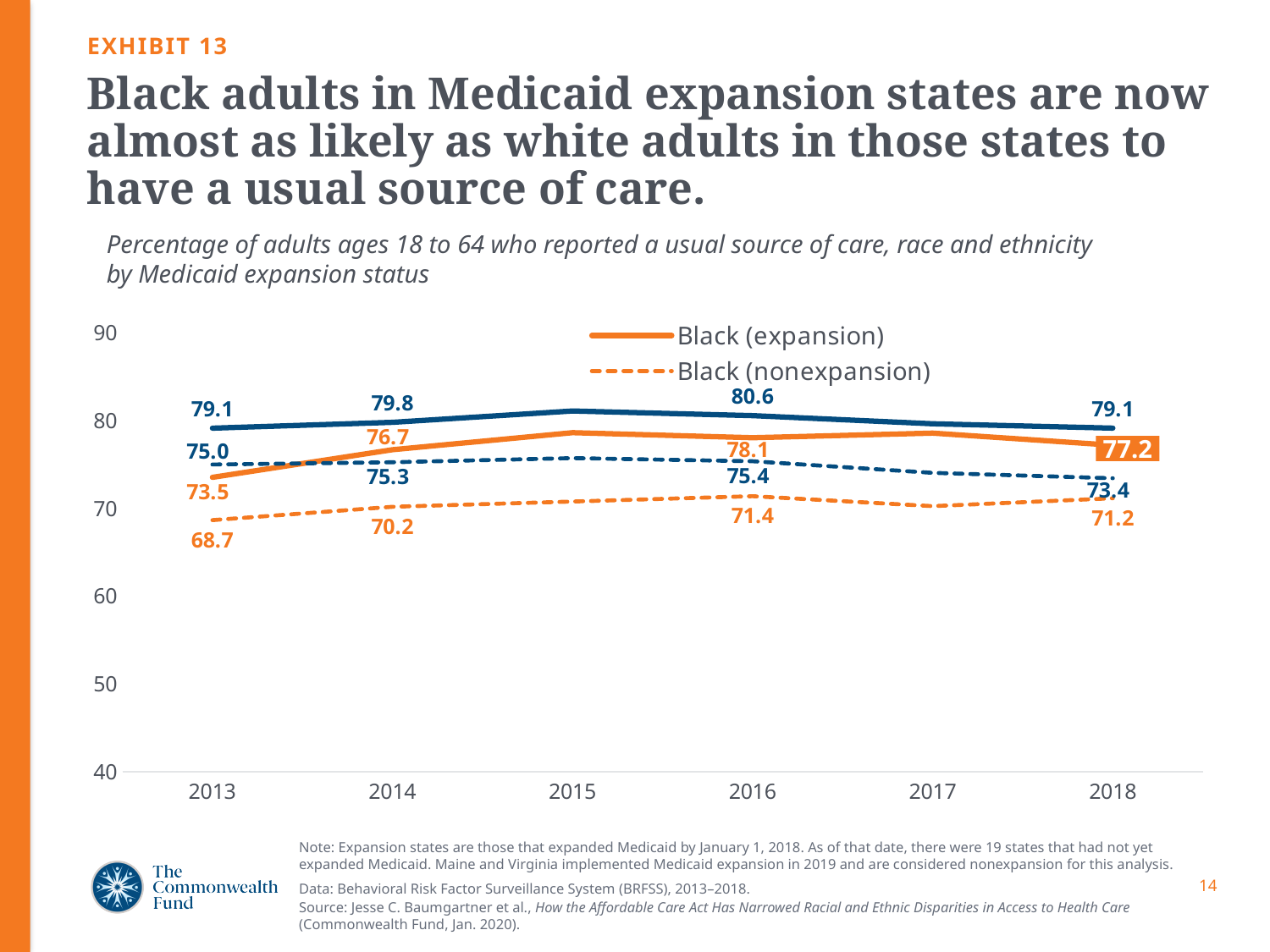
How many series does the legend list? 2 What is the value for Black (expansion) in 2013? 73.5 What is the value for Black (expansion) in 2018? 77.2 Is the value for Black (nonexpansion) in 2013 greater or less than 70? less By how much did the Black (expansion) value change from 2013 to 2018? 3.7 What is the value for Black (nonexpansion) in 2018? 71.2 What is the difference between Black (expansion) and Black (nonexpansion) in 2018? 6.0 In 2016, which is larger: Black (expansion) or Black (nonexpansion)? Black (expansion) What kind of chart is shown on the slide? line chart In which year is the Black (nonexpansion) value lowest? 2013 What is the value for Black (nonexpansion) in 2014? 70.2 How many years are shown on the x axis? 6